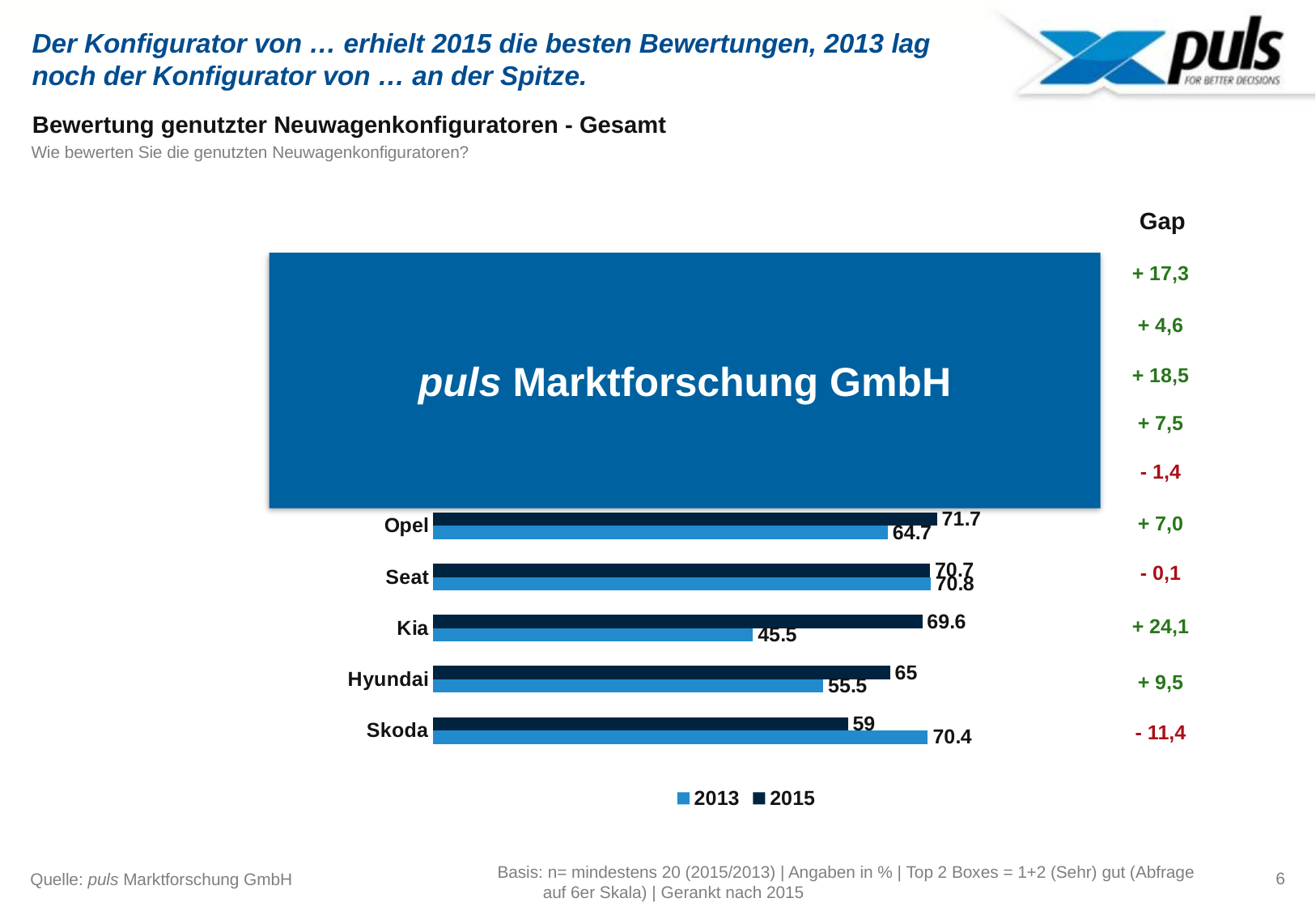
Which has the larger 2015 value, Opel or Seat? Opel What is the 2013 value for Skoda? 70.4 Among Opel, Seat, Kia, Hyundai and Skoda, which has the lowest 2015 value? Skoda What is the difference between Kia's 2015 value and its 2013 value? 24.1 What is the 2015 value for Hyundai? 65 What kind of chart is shown on the slide? bar chart What is the 2015 value for Opel? 71.7 What is the difference between Skoda's 2013 value and its 2015 value? 11.4 How many series does the legend list? 2 What is the 2013 value for Kia? 45.5 What is the Gap value shown for Kia? + 24,1 For Skoda, which year has the larger value, 2013 or 2015? 2013